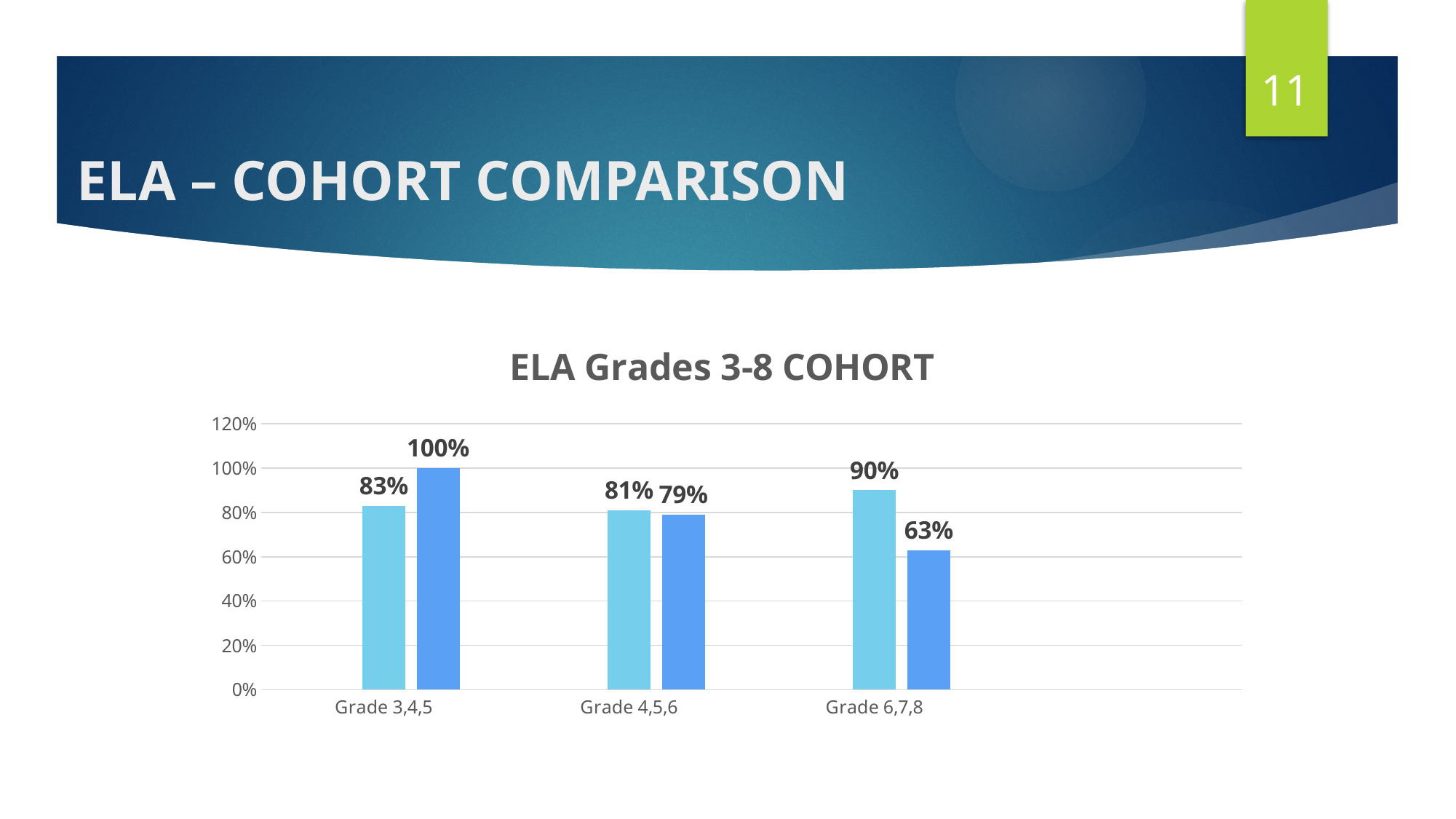
Is the value of the darker blue (second) bar for Grade 6,7,8 greater or less than 80%? less For Grade 3,4,5, which bar is larger, the light blue (first) or the darker blue (second)? darker blue (second) What is the difference between the light blue and darker blue bars for Grade 6,7,8? 27% What is the value of the darker blue (second) bar for Grade 6,7,8? 63% What is the value of the light blue (first) bar for Grade 3,4,5? 83% What is the value of the light blue (first) bar for Grade 4,5,6? 81% What is the chart title? ELA Grades 3-8 COHORT What kind of chart is shown on the slide? bar chart What is the value of the darker blue (second) bar for Grade 3,4,5? 100% How many grade categories are shown on the x axis? 3 Which category has the lowest value among the darker blue (second) bars? Grade 6,7,8 Which category has the highest value among the darker blue (second) bars? Grade 3,4,5